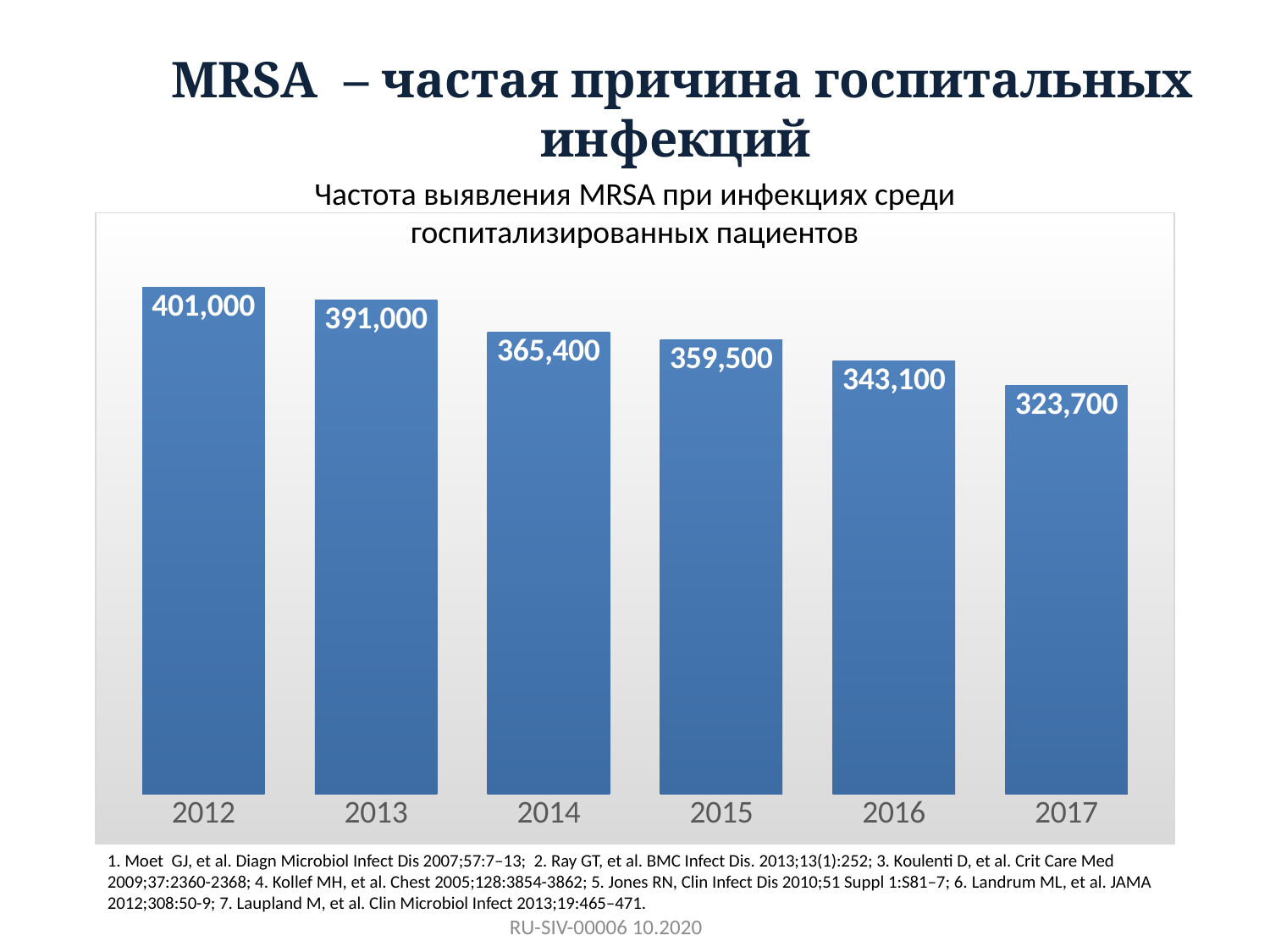
Which year has the lowest value? 2017 What kind of chart is shown on the slide? Bar chart Which is larger, the value for 2014 or the value for 2016? 2014 What is the value for 2015? 359,500 What is the difference between the values for 2012 and 2017? 77,300 What is the value for 2017? 323,700 What is the difference between the values for 2013 and 2014? 25,600 Do the values rise or fall from 2012 to 2017? Fall How many years are shown on the chart? 6 What is the title of the chart? Частота выявления MRSA при инфекциях среди госпитализированных пациентов Which year has the highest value? 2012 What is the value for 2012? 401,000